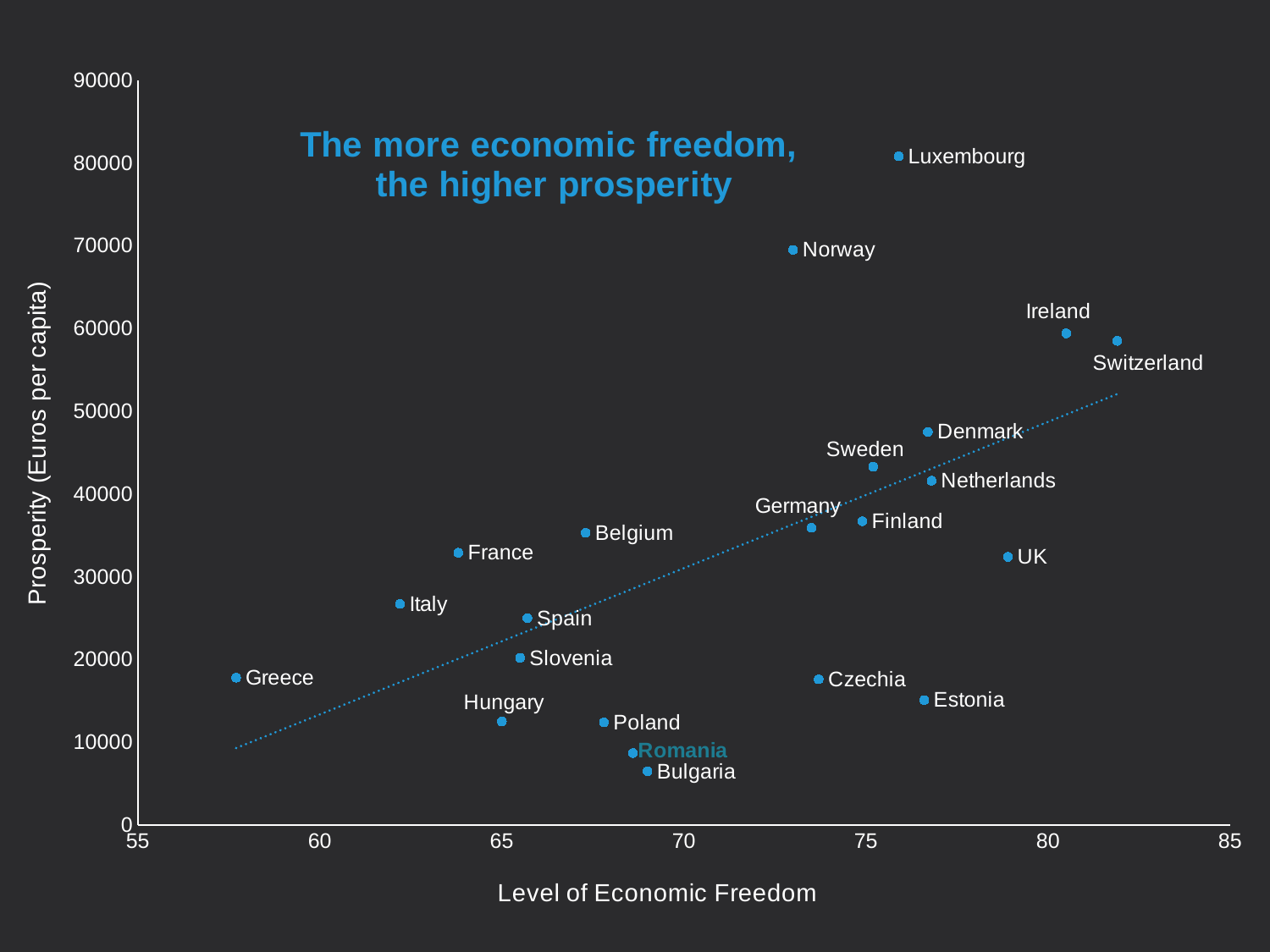
Which has higher prosperity, France or Italy? France Which country has the highest prosperity (Euros per capita) on the chart? Luxembourg Which country has the lowest prosperity (Euros per capita) on the chart? Bulgaria Is the prosperity value for Norway greater or less than 60000? greater What kind of chart is shown on the slide? scatter chart How many countries are plotted on the chart? 22 Which country has the highest level of economic freedom on the chart? Switzerland Which has higher prosperity, Norway or Sweden? Norway What is the title of the chart? The more economic freedom, the higher prosperity Which country has the lowest level of economic freedom on the chart? Greece Is the prosperity value for Greece greater or less than 20000? less Is the prosperity value for UK greater or less than 40000? less